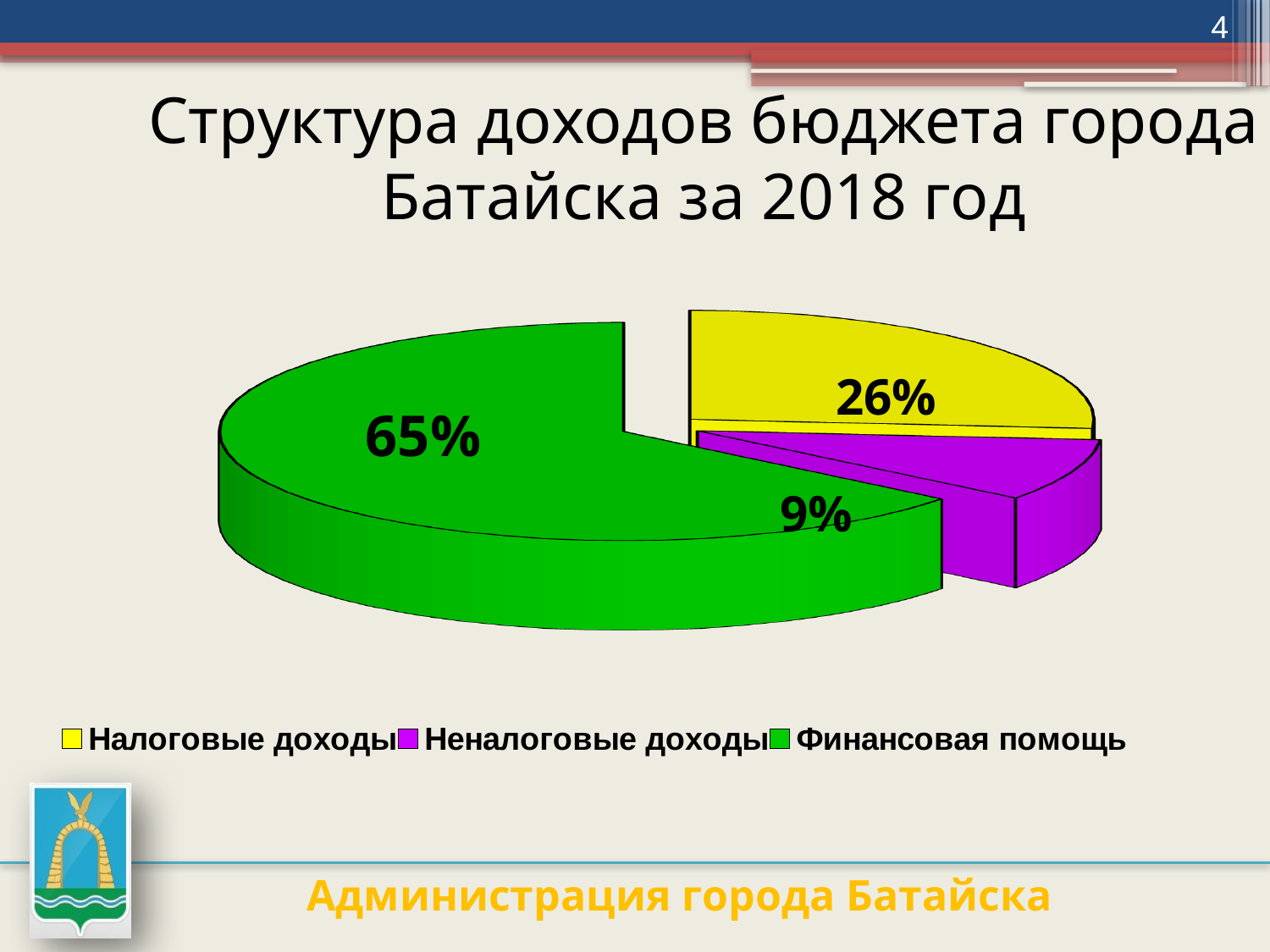
Which colour represents Неналоговые доходы in the legend? Purple What share of the pie does Неналоговые доходы account for? 9% What is the difference in percentage points between Финансовая помощь and Налоговые доходы? 39 Which category has the smallest slice of the pie? Неналоговые доходы What kind of chart is shown on the slide? Pie chart What is the title of the chart on the slide? Структура доходов бюджета города Батайска за 2018 год What is the difference in percentage points between Налоговые доходы and Неналоговые доходы? 17 Which category has the largest slice of the pie? Финансовая помощь What share of the pie does Налоговые доходы account for? 26% What share of the pie does Финансовая помощь account for? 65% Which is larger, the share for Налоговые доходы or the share for Неналоговые доходы? Налоговые доходы How many categories are shown in the pie chart? 3